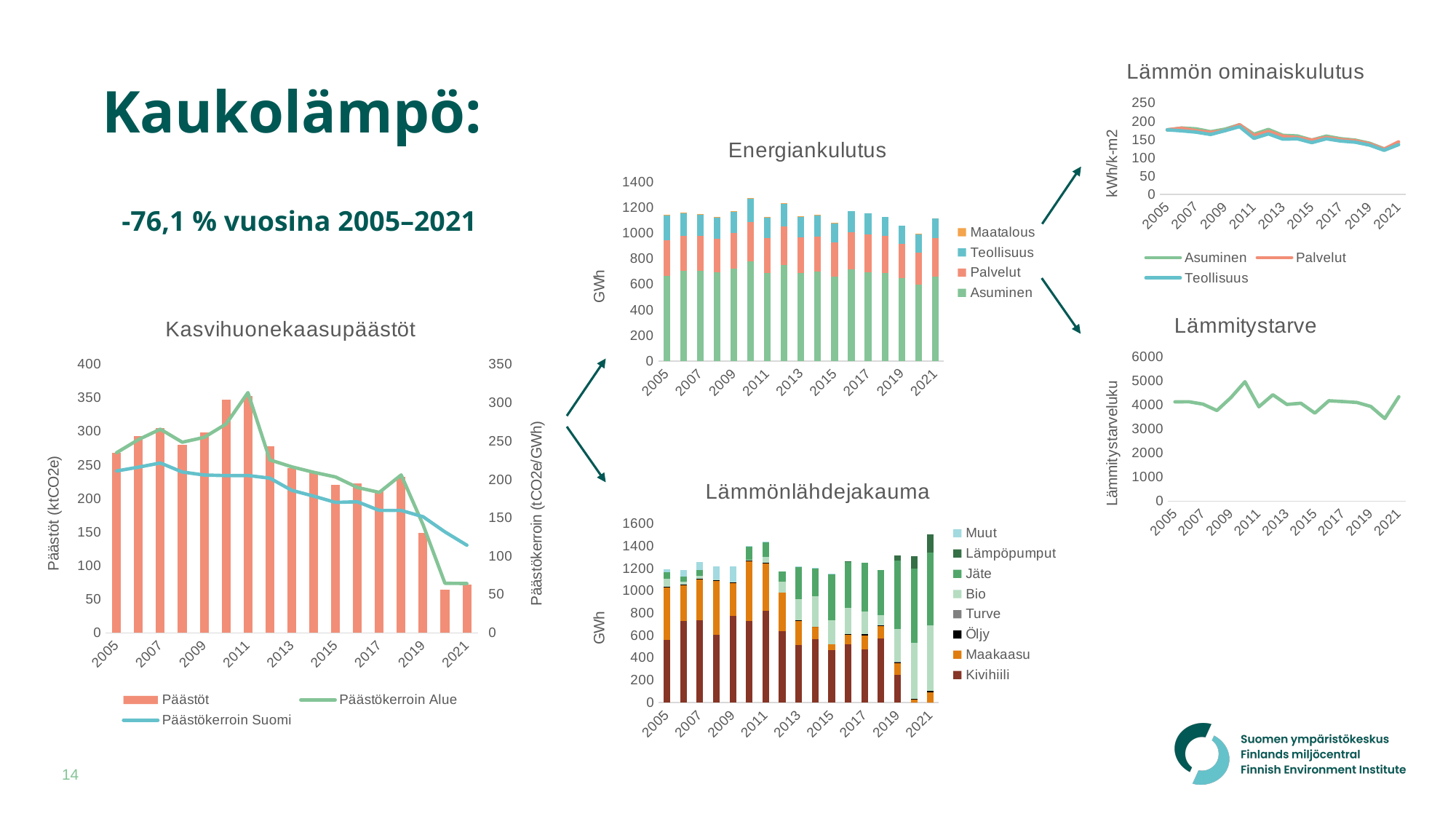
How many years (bars) are shown on the x axis of the Energiankulutus chart? 17 In the Kasvihuonekaasupäästöt chart, does the Päästökerroin Suomi line rise or fall from 2005 to 2021? fall In the Kasvihuonekaasupäästöt chart, is the Päästöt value for 2020 greater or less than 100? less In the Kasvihuonekaasupäästöt chart, which year has the highest Päästöt bar? 2011 In the Lämmönlähdejakauma chart, which year has the tallest stacked bar? 2021 In the Lämmön ominaiskulutus chart, does the Asuminen line rise or fall from 2005 to 2021? fall How many series does the legend of the Lämmönlähdejakauma chart list? 8 How many series does the legend of the Kasvihuonekaasupäästöt chart list? 3 In the Lämmitystarve chart, which year has the highest value? 2010 In the Kasvihuonekaasupäästöt chart, is the Päästöt value for 2005 greater or less than 250? greater What kind of chart is the Energiankulutus chart? bar chart In the Energiankulutus chart, is the total for 2019 greater or less than 1200? less